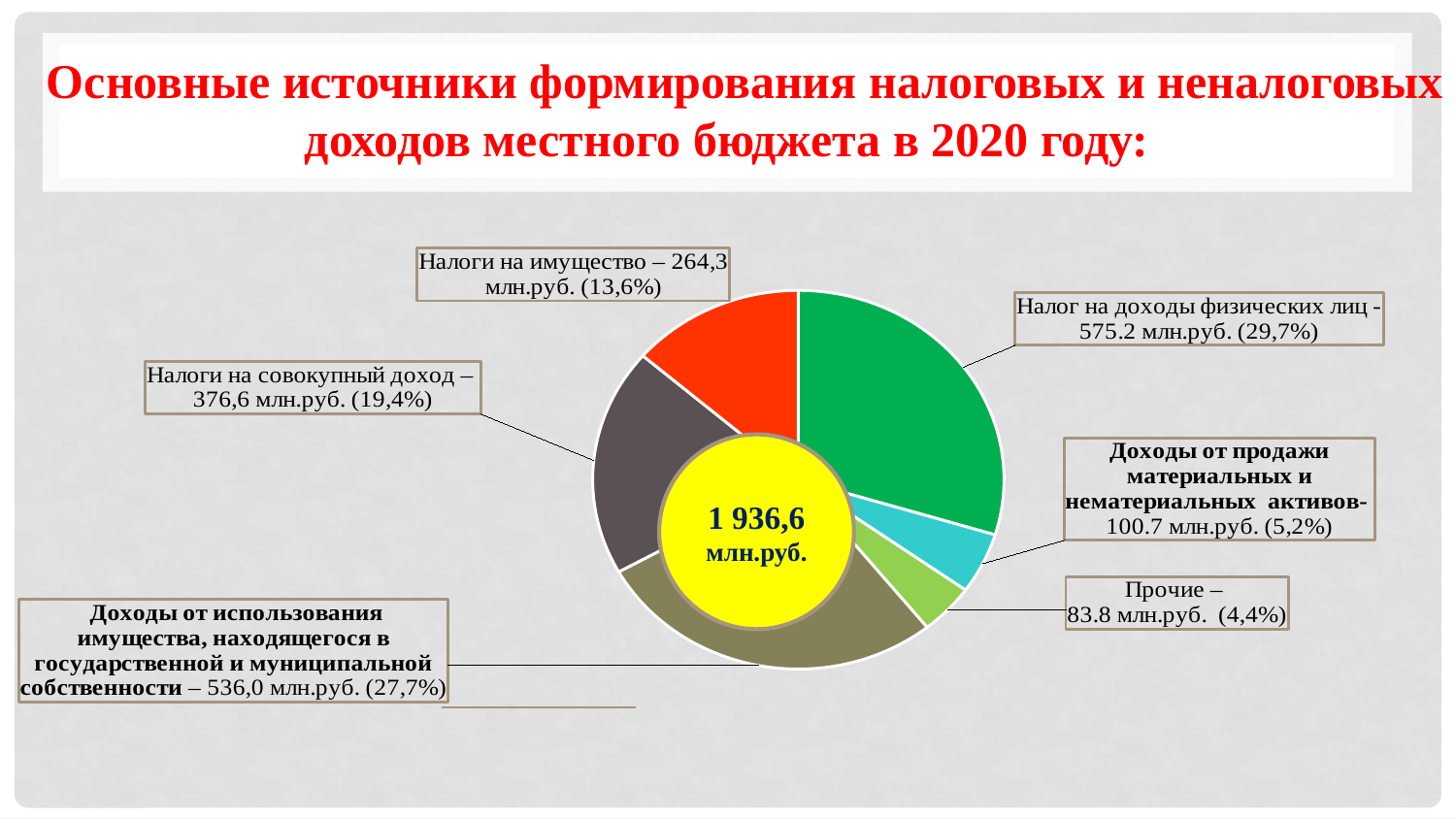
What share of the pie does Налоги на совокупный доход represent? 19,4% Which category has the largest slice? Налог на доходы физических лиц Which is larger: Доходы от продажи материальных и нематериальных активов or Прочие? Доходы от продажи материальных и нематериальных активов Which category has the smallest slice? Прочие What total value is shown in the centre of the pie chart? 1 936,6 млн.руб. What is the difference in percentage points between Налог на доходы физических лиц and Доходы от использования имущества, находящегося в государственной и муниципальной собственности? 2,0% How many slices does the pie chart have? 6 What is the value for Прочие? 83.8 млн.руб. What is the value for Налог на доходы физических лиц? 575.2 млн.руб. What is the difference in млн.руб. between Налоги на совокупный доход and Налоги на имущество? 112,3 млн.руб. What share of the pie does Налоги на имущество represent? 13,6% What kind of chart is shown on the slide? pie chart